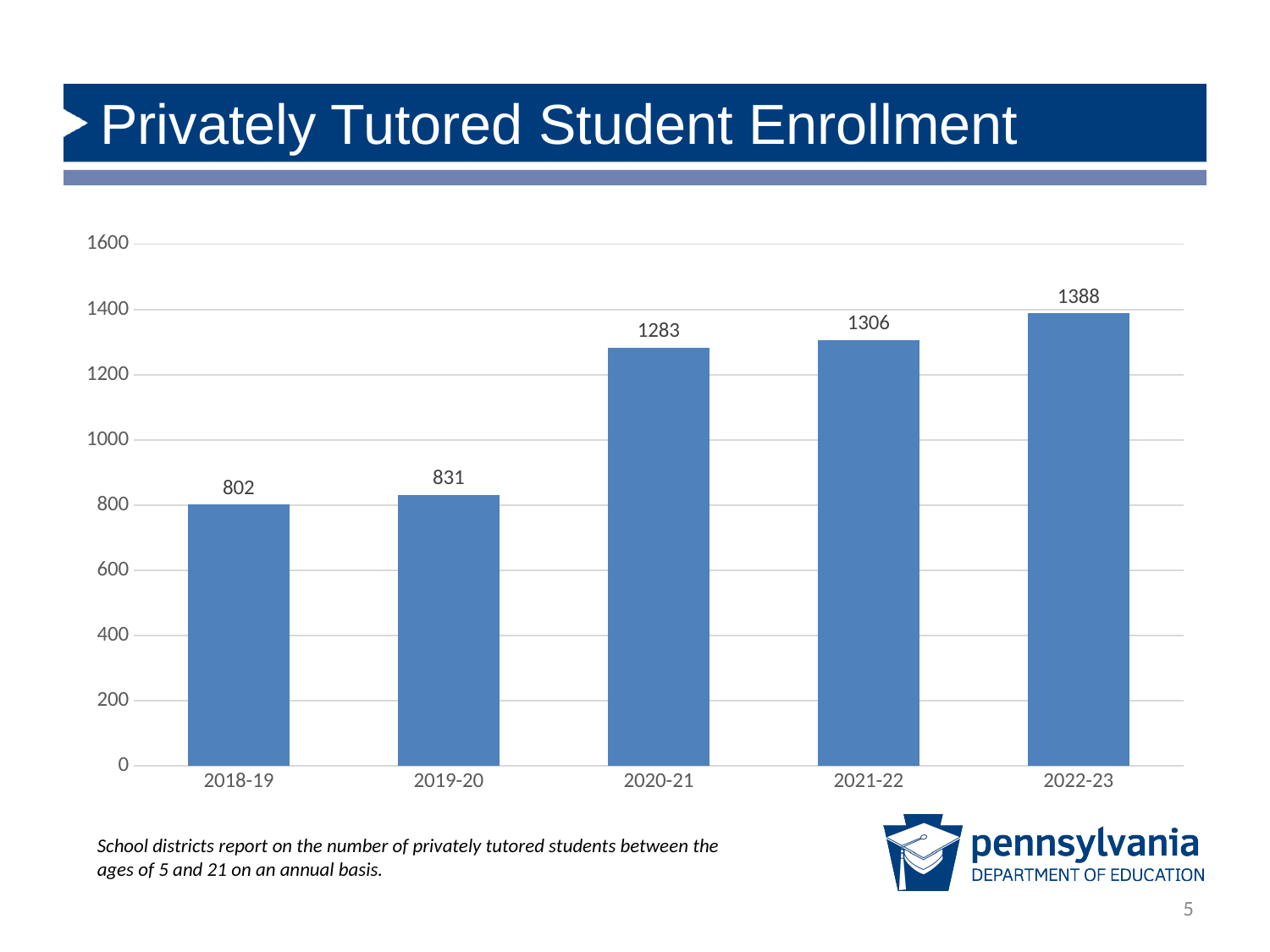
What is the difference in enrollment between 2022-23 and 2018-19? 586 Which school year has the highest privately tutored student enrollment? 2022-23 Does privately tutored student enrollment rise or fall from 2018-19 to 2022-23? Rise How many school years are shown on the chart? 5 Is the enrollment for 2021-22 greater or less than 1200? greater What is the privately tutored student enrollment for 2020-21? 1283 Which year has the larger enrollment, 2019-20 or 2021-22? 2021-22 What is the difference in enrollment between 2020-21 and 2019-20? 452 What is the privately tutored student enrollment for 2018-19? 802 What kind of chart is shown on the slide? Bar chart Which school year has the lowest privately tutored student enrollment? 2018-19 What is the privately tutored student enrollment for 2022-23? 1388